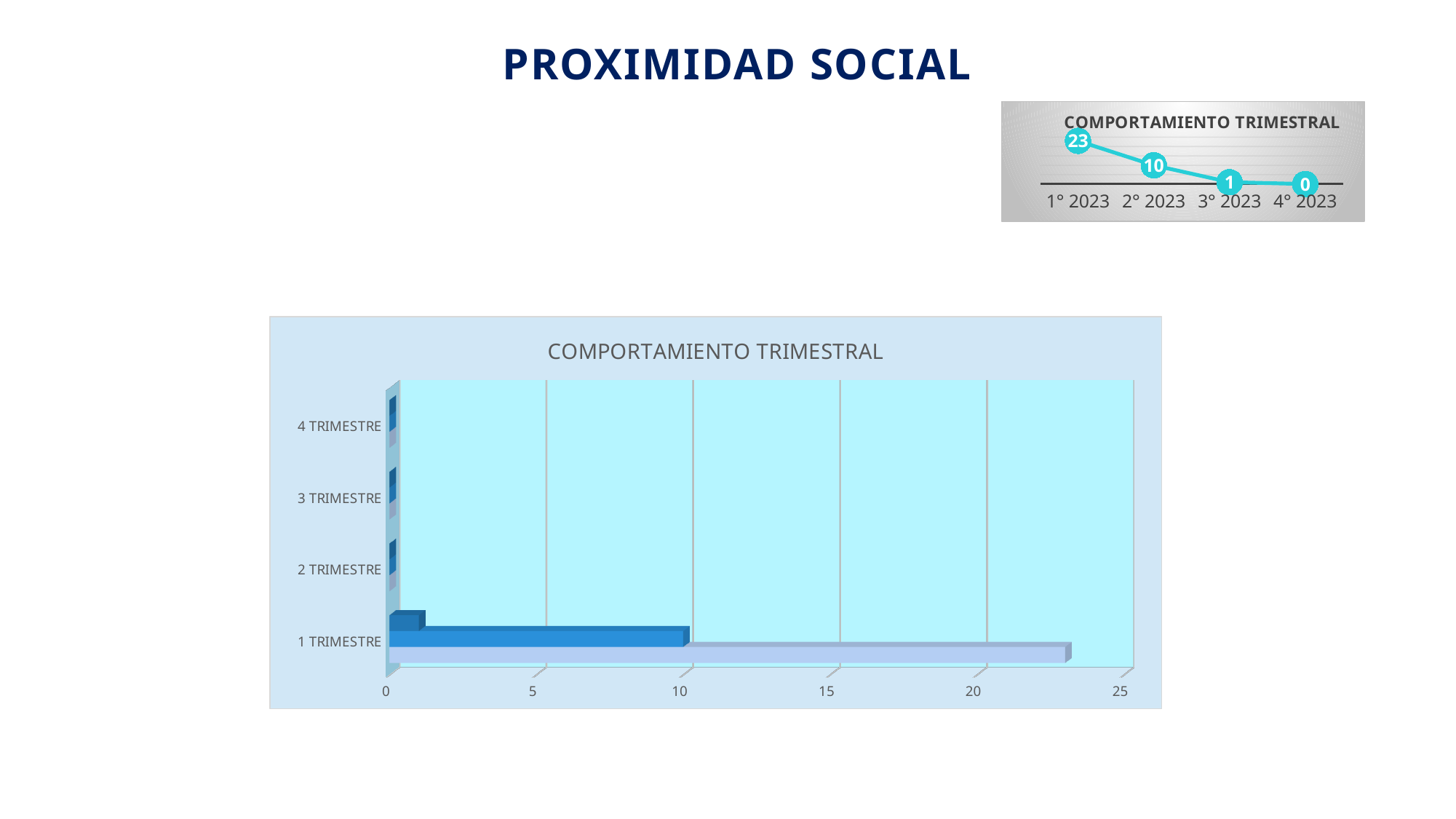
In the bar chart at the bottom, how many categories are shown on the vertical axis? 4 In the line chart at the top right, what is the difference between the values for 1° 2023 and 2° 2023? 13 In the line chart at the top right, how many data points are plotted? 4 What kind of chart is the large chart at the bottom of the slide? bar chart In the line chart at the top right, which quarter has the lowest value? 4° 2023 In the line chart at the top right, what is the value for 1° 2023? 23 In the line chart at the top right, which quarter has the highest value? 1° 2023 In the line chart at the top right, what is the value for 3° 2023? 1 In the line chart at the top right, what is the value for 2° 2023? 10 In the bar chart at the bottom, is the longest bar for 1 TRIMESTRE greater or less than 20? greater In the line chart at the top right, what is the value for 4° 2023? 0 In the line chart at the top right, do the values rise or fall from 1° 2023 to 4° 2023? fall